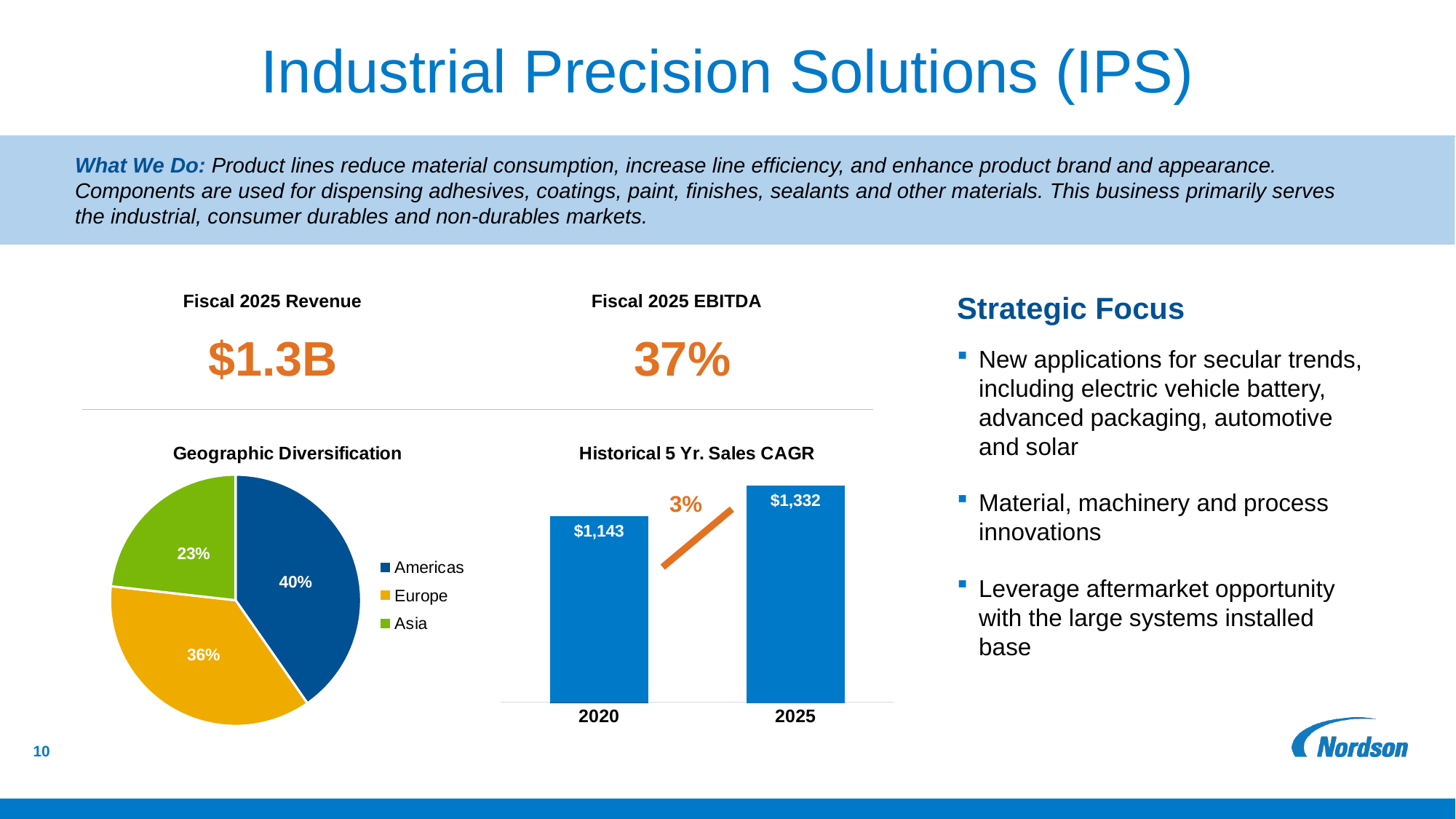
In the Geographic Diversification pie chart, which region has the smallest share? Asia In the Geographic Diversification pie chart, what share does Europe have? 36% In the Historical 5 Yr. Sales CAGR chart, what is the difference between the 2025 and 2020 values? $189 In the Geographic Diversification pie chart, what share does Asia have? 23% In the Historical 5 Yr. Sales CAGR chart, what is the value for 2020? $1,143 In the Historical 5 Yr. Sales CAGR chart, do the values rise or fall from 2020 to 2025? Rise In the Geographic Diversification pie chart, which region has the largest share? Americas What kind of chart is the Historical 5 Yr. Sales CAGR chart? Bar chart In the Geographic Diversification pie chart, what share does Americas have? 40% In the Geographic Diversification pie chart, how many slices are there? 3 What kind of chart is the Geographic Diversification chart? Pie chart In the Historical 5 Yr. Sales CAGR chart, what is the value for 2025? $1,332